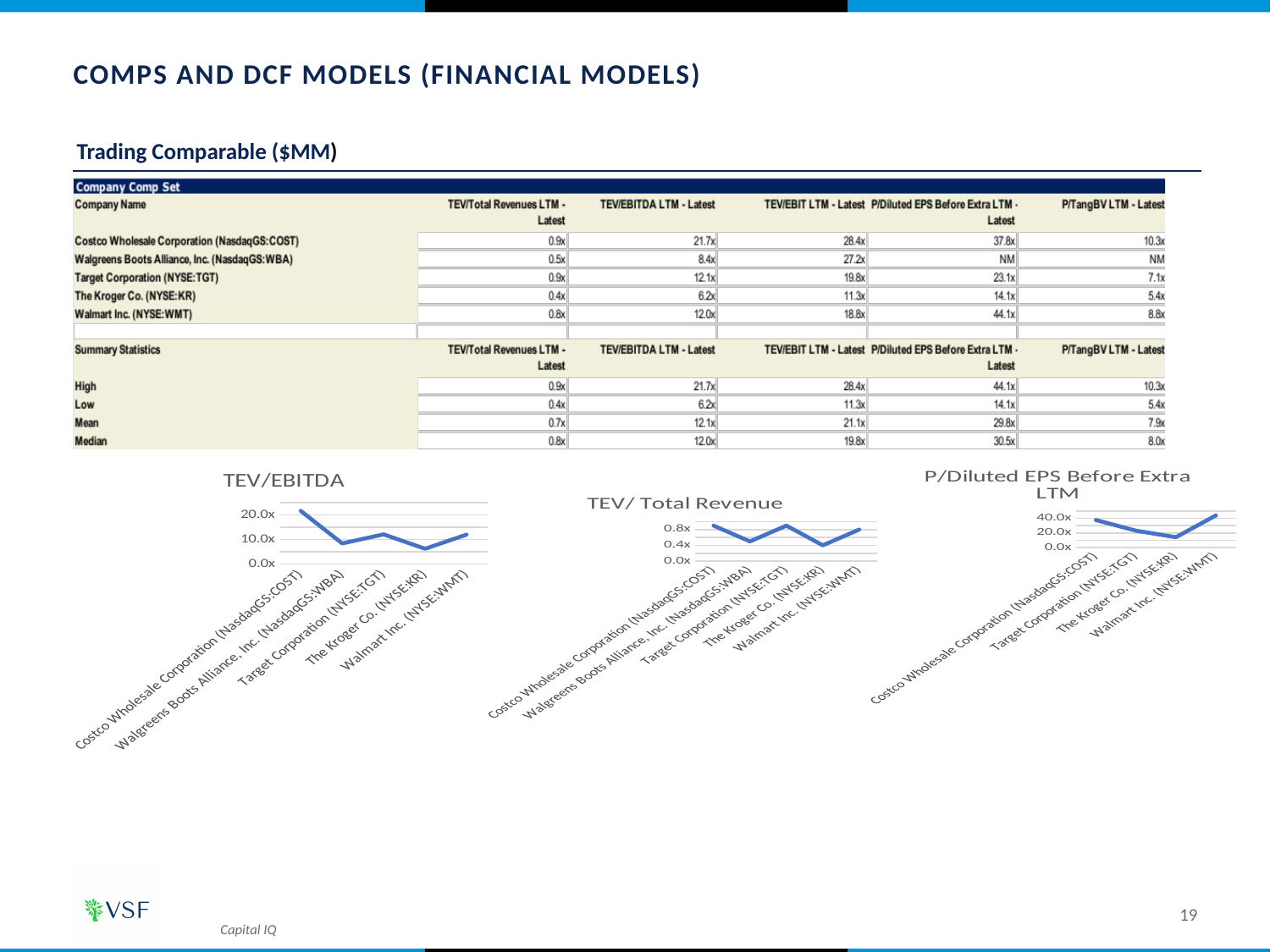
In the P/Diluted EPS Before Extra LTM chart, is the value for Walmart Inc. greater or less than 40.0x? greater How many companies are plotted in the P/Diluted EPS Before Extra LTM chart? 4 What kind of chart is the TEV/EBITDA chart? line chart In the TEV/EBITDA chart, which company has the highest value? Costco Wholesale Corporation (NasdaqGS:COST) In the TEV/ Total Revenue chart, which is larger, the value for Costco Wholesale Corporation or the value for Walgreens Boots Alliance? Costco Wholesale Corporation In the P/Diluted EPS Before Extra LTM chart, which company has the lowest value? The Kroger Co. (NYSE:KR) In the TEV/EBITDA chart, is the value for The Kroger Co. greater or less than 10.0x? less In the TEV/ Total Revenue chart, is the value for The Kroger Co. greater or less than 0.8x? less How many companies are plotted in the TEV/EBITDA chart? 5 How many charts are shown on the slide? 3